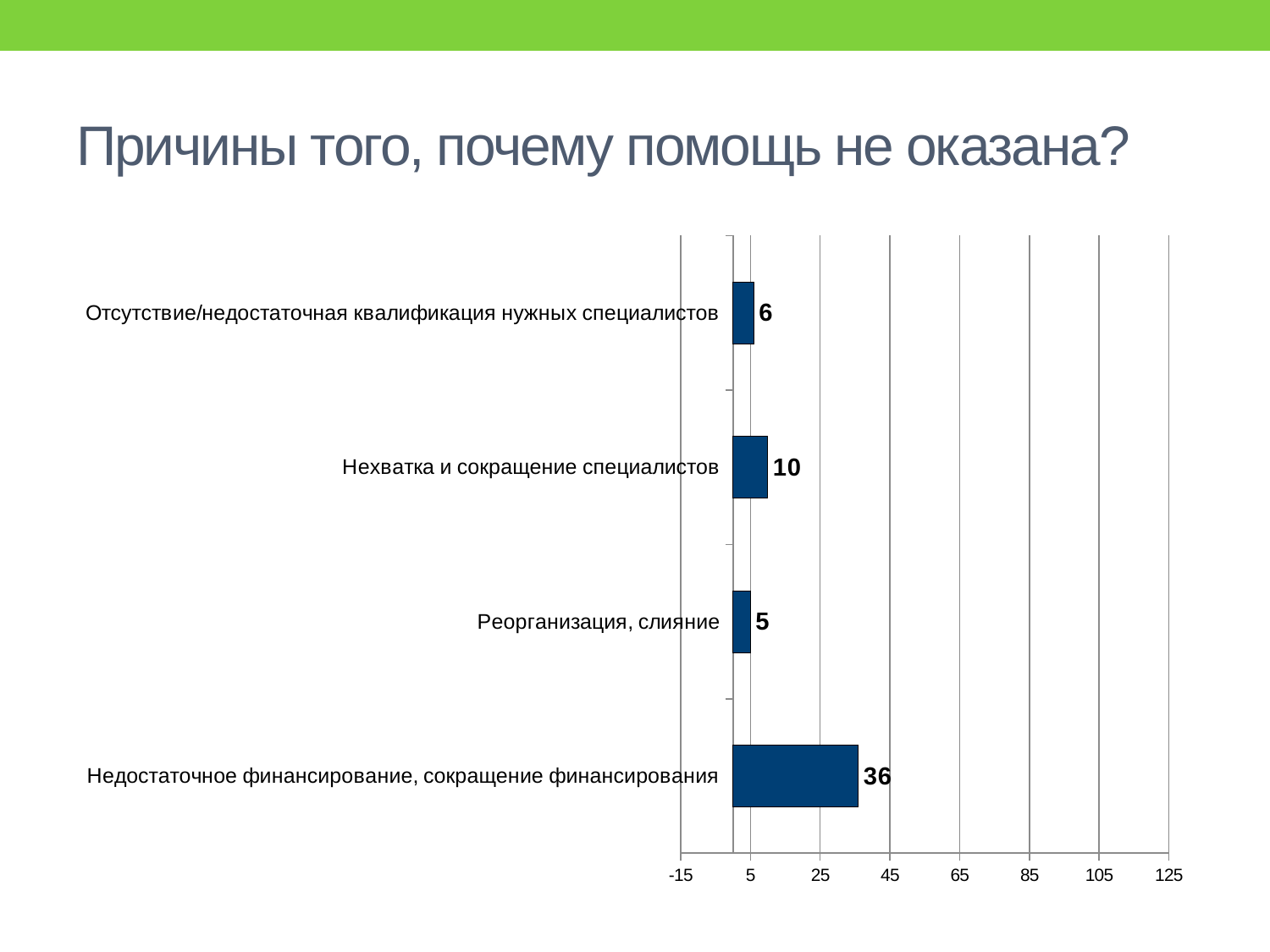
What is the value for "Реорганизация, слияние"? 5 What kind of chart is shown on the slide? bar chart Is the value for "Недостаточное финансирование, сокращение финансирования" greater or less than 45? less What is the title of the slide? Причины того, почему помощь не оказана? What is the value for "Нехватка и сокращение специалистов"? 10 What is the value for "Недостаточное финансирование, сокращение финансирования"? 36 What is the value for "Отсутствие/недостаточная квалификация нужных специалистов"? 6 Which category has the highest value? Недостаточное финансирование, сокращение финансирования What is the difference between the values for "Недостаточное финансирование, сокращение финансирования" and "Нехватка и сокращение специалистов"? 26 How many categories are shown in the chart? 4 Which category has the lowest value? Реорганизация, слияние Which is larger: the value for "Нехватка и сокращение специалистов" or the value for "Отсутствие/недостаточная квалификация нужных специалистов"? Нехватка и сокращение специалистов